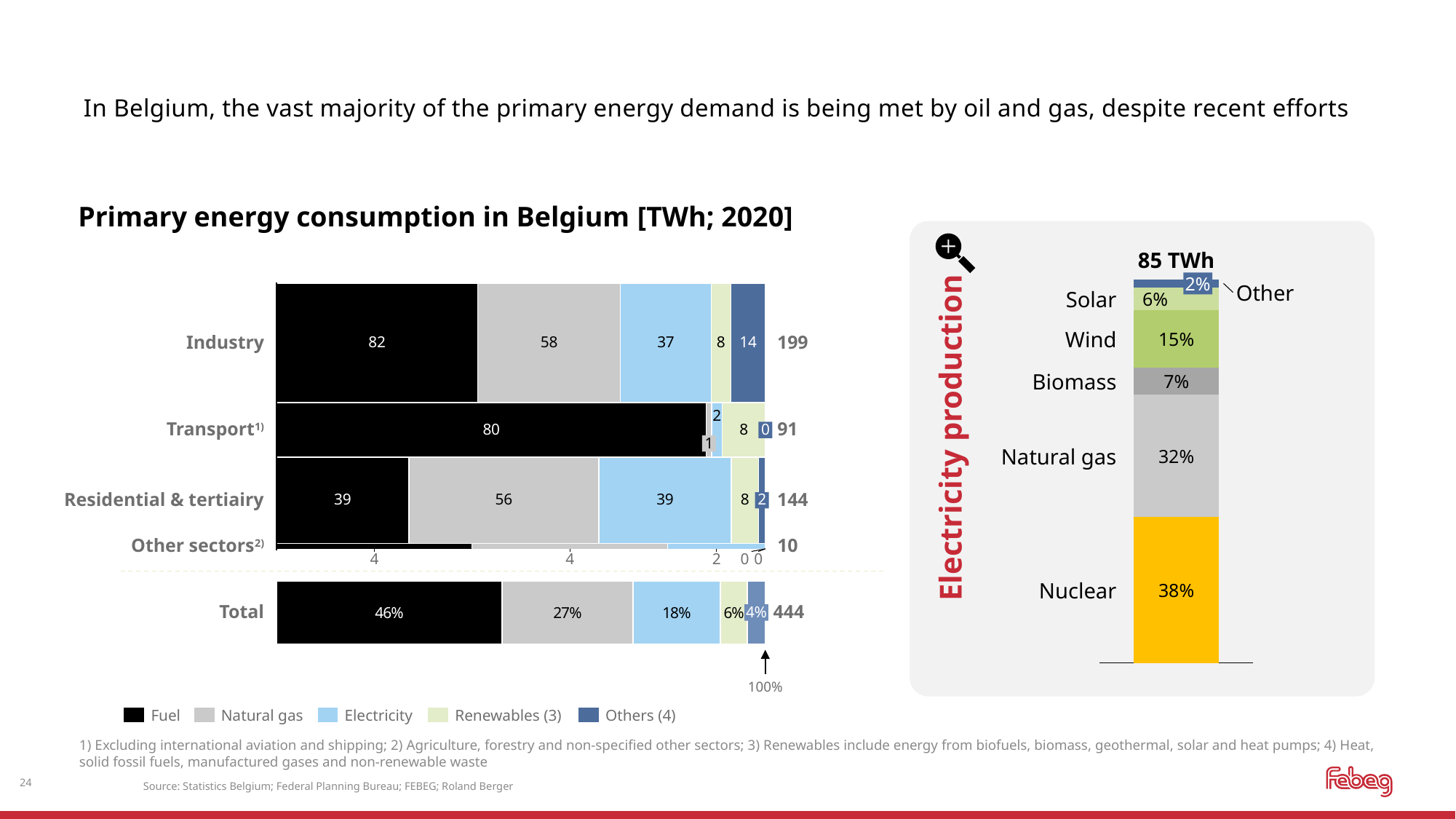
In the 'Primary energy consumption in Belgium' chart, what share of the Total does Fuel account for? 46% In the 'Electricity production' chart on the right, which source has the largest share? Nuclear In the 'Electricity production' chart on the right, what share does Nuclear account for? 38% In the 'Primary energy consumption in Belgium' chart, what is the Fuel value for Industry? 82 In the 'Primary energy consumption in Belgium' chart, what is the Natural gas value for Residential & tertiairy? 56 In the 'Primary energy consumption in Belgium' chart, which sector has the highest total consumption? Industry How many series does the legend of the 'Primary energy consumption in Belgium' chart list? 5 What kind of chart is the 'Primary energy consumption in Belgium' chart? Stacked bar chart In the 'Primary energy consumption in Belgium' chart, what is the total shown for Transport? 91 In the 'Primary energy consumption in Belgium' chart, which is larger for Industry: Natural gas or Electricity? Natural gas In the 'Electricity production' chart on the right, what is the total electricity production shown above the bar? 85 TWh In the 'Primary energy consumption in Belgium' chart, what is the difference between the Industry total and the Residential & tertiairy total? 55